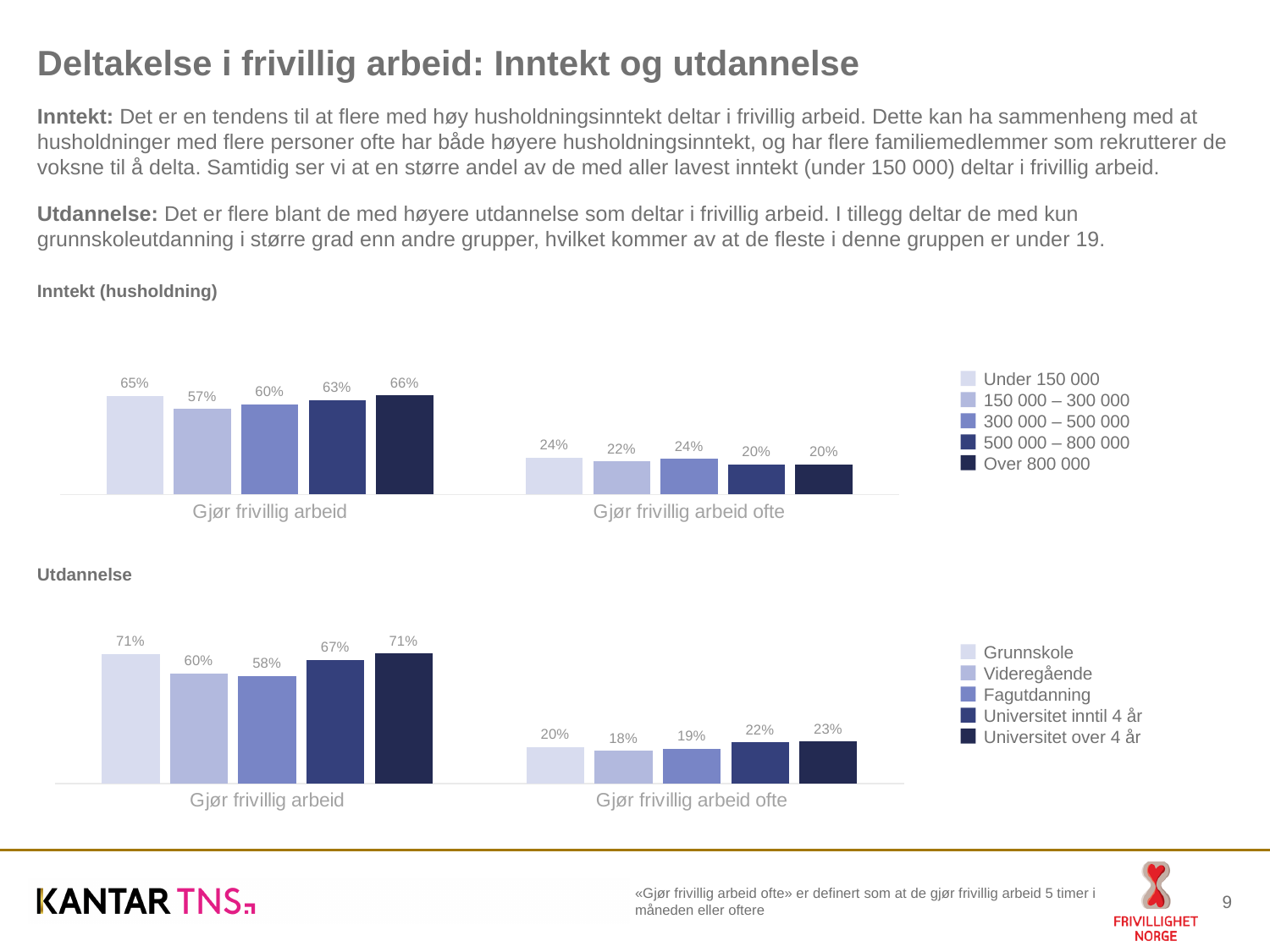
In the 'Utdannelse' chart, how many categories are shown on the x axis? 2 In the 'Utdannelse' chart, which is larger in the 'Gjør frivillig arbeid' group: 'Videregående' or 'Universitet inntil 4 år'? Universitet inntil 4 år In the 'Inntekt (husholdning)' chart, what is the value for '150 000 – 300 000' in the 'Gjør frivillig arbeid ofte' group? 22% In the 'Utdannelse' chart, what is the value for 'Universitet over 4 år' in the 'Gjør frivillig arbeid ofte' group? 23% In the 'Inntekt (husholdning)' chart, which income group has the lowest value in the 'Gjør frivillig arbeid' group? 150 000 – 300 000 In the 'Inntekt (husholdning)' chart, how many series does the legend list? 5 In the 'Utdannelse' chart, what is the difference between 'Grunnskole' and 'Fagutdanning' in the 'Gjør frivillig arbeid' group? 13 percentage points In the 'Inntekt (husholdning)' chart, what is the difference between 'Over 800 000' and '150 000 – 300 000' in the 'Gjør frivillig arbeid' group? 9 percentage points In the 'Utdannelse' chart, what is the value for 'Fagutdanning' in the 'Gjør frivillig arbeid' group? 58% In the 'Utdannelse' chart, which education group has the lowest value in the 'Gjør frivillig arbeid ofte' group? Videregående In the 'Inntekt (husholdning)' chart, what is the value for 'Over 800 000' in the 'Gjør frivillig arbeid' group? 66% What kind of chart is the 'Utdannelse' chart? Bar chart